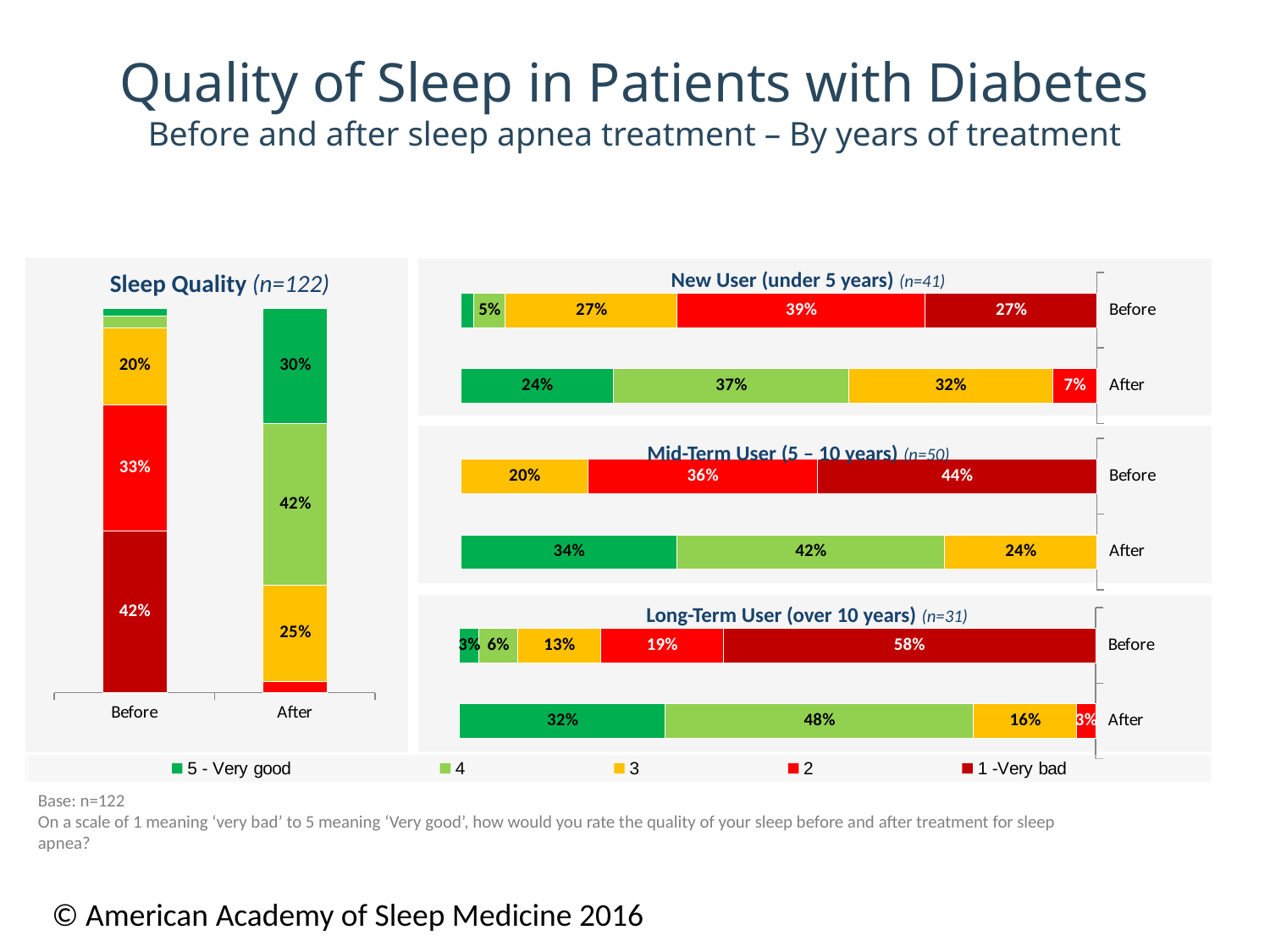
In the Mid-Term User (5 – 10 years) chart, what do the three labelled segments of the After bar add up to? 100% In the Sleep Quality (n=122) chart, what percentage rated their sleep 5 - Very good after treatment? 30% How many rating categories does the legend at the bottom of the slide list? 5 In the Long-Term User (over 10 years) chart, which rating has the largest share in the Before bar? 1 - Very bad In the Mid-Term User (5 – 10 years) chart, which is larger after treatment: the share rating 5 - Very good or the share rating 3? 5 - Very good In the New User (under 5 years) chart, what percentage gave a rating of 2 after treatment? 7% In the Mid-Term User (5 – 10 years) chart, what percentage rated their sleep 1 - Very bad before treatment? 44% In the New User (under 5 years) chart, what is the difference between the share giving a rating of 3 after treatment and before treatment? 5 percentage points In the Sleep Quality (n=122) chart, what percentage of patients rated their sleep 1 - Very bad before treatment? 42% In the Long-Term User (over 10 years) chart, by how many percentage points did the share giving a rating of 4 increase from Before to After? 42 percentage points What type of chart is the Sleep Quality (n=122) chart? Stacked bar chart In the Long-Term User (over 10 years) chart, what percentage rated their sleep 1 - Very bad before treatment? 58%